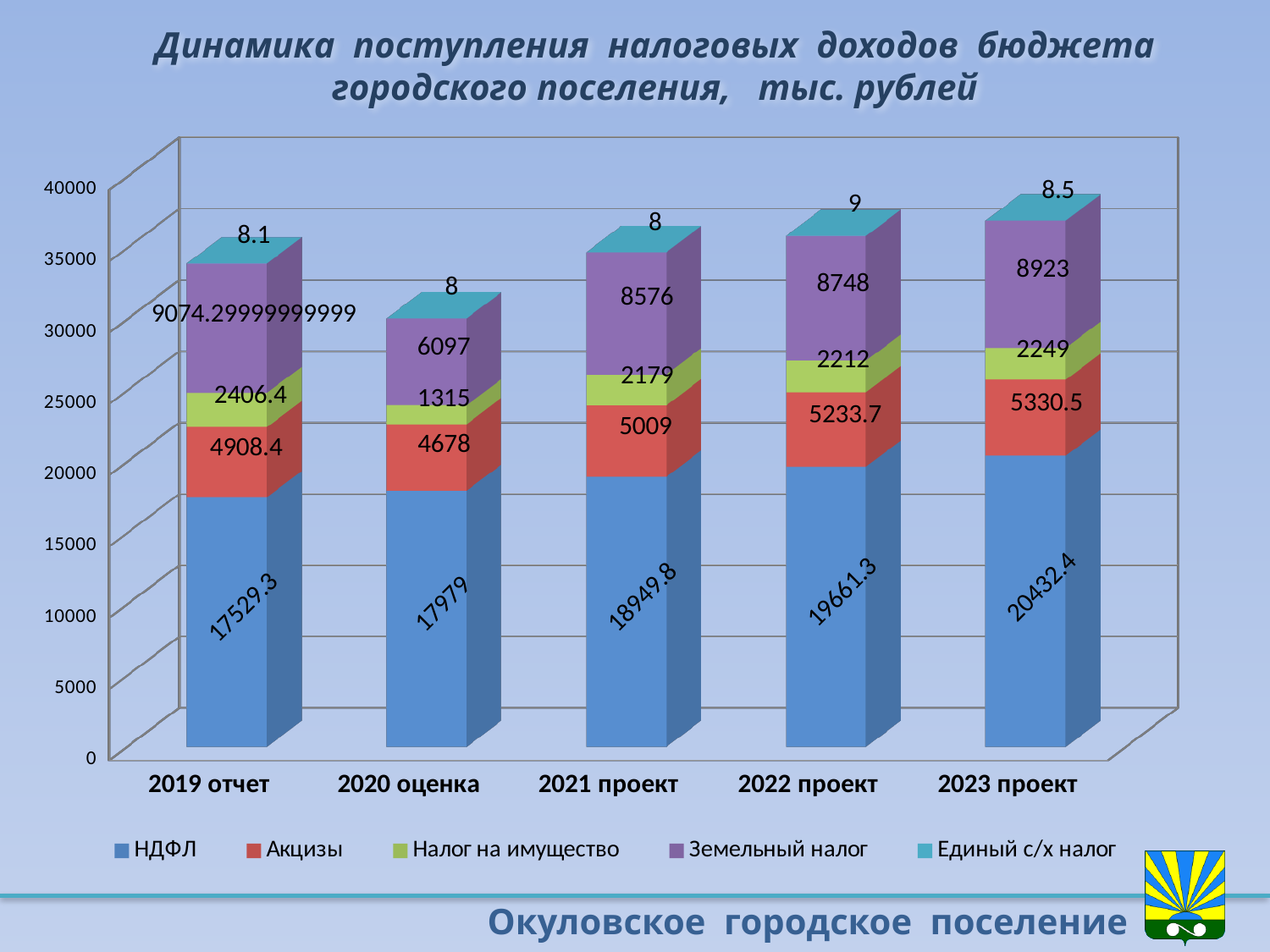
Which category has the highest НДФЛ value? 2023 проект Does the НДФЛ value rise or fall from 2019 отчет to 2023 проект? Rises What is the Единый с/х налог value for 2023 проект? 8.5 What is the Земельный налог value for 2020 оценка? 6097 How many categories are shown on the x axis? 5 Which category has the lowest Налог на имущество value? 2020 оценка What is the Акцизы value for 2022 проект? 5233.7 What is the НДФЛ value for 2021 проект? 18949.8 How many series does the legend list? 5 What is the difference between the Акцизы values for 2023 проект and 2020 оценка? 652.5 Which is larger: Земельный налог for 2021 проект or for 2022 проект? 2022 проект What kind of chart is shown on the slide? Stacked bar chart